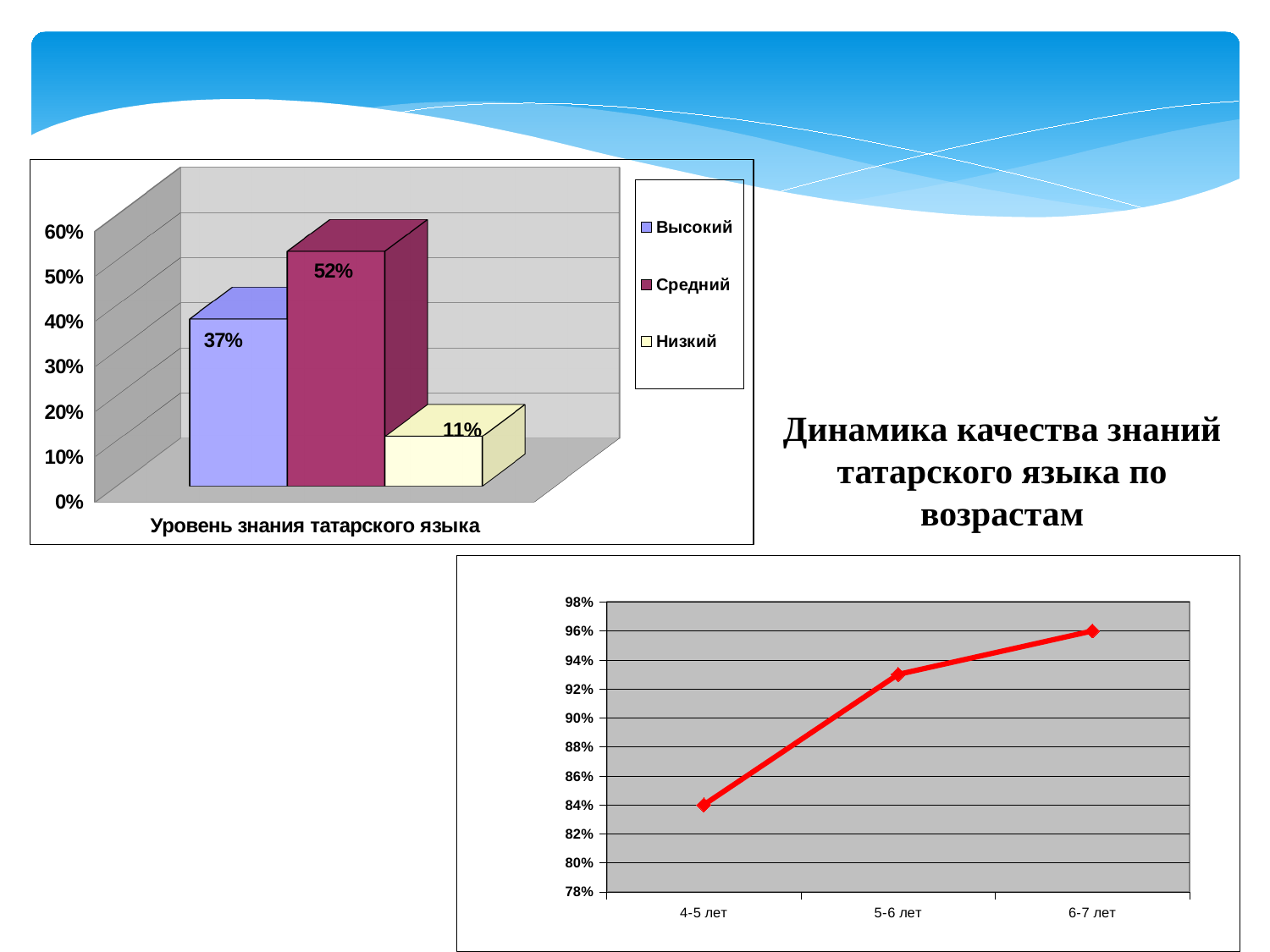
In the chart 'Динамика качества знаний татарского языка по возрастам', how many age groups are plotted? 3 In the chart 'Динамика качества знаний татарского языка по возрастам', is the value for 5-6 лет greater or less than 90%? greater In the bar chart 'Уровень знания татарского языка', what is the value for Высокий? 37% In the bar chart 'Уровень знания татарского языка', which category has the highest value? Средний In the bar chart 'Уровень знания татарского языка', what is the value for Средний? 52% In the bar chart 'Уровень знания татарского языка', what is the difference between Средний and Высокий? 15% What kind of chart is the chart at the bottom right of the slide? line chart In the bar chart 'Уровень знания татарского языка', what is the value for Низкий? 11% In the chart 'Динамика качества знаний татарского языка по возрастам', do the values rise or fall from 4-5 лет to 6-7 лет? rise What kind of chart is the chart on the left of the slide? bar chart In the bar chart 'Уровень знания татарского языка', how many entries does the legend list? 3 In the bar chart 'Уровень знания татарского языка', which category has the lowest value? Низкий